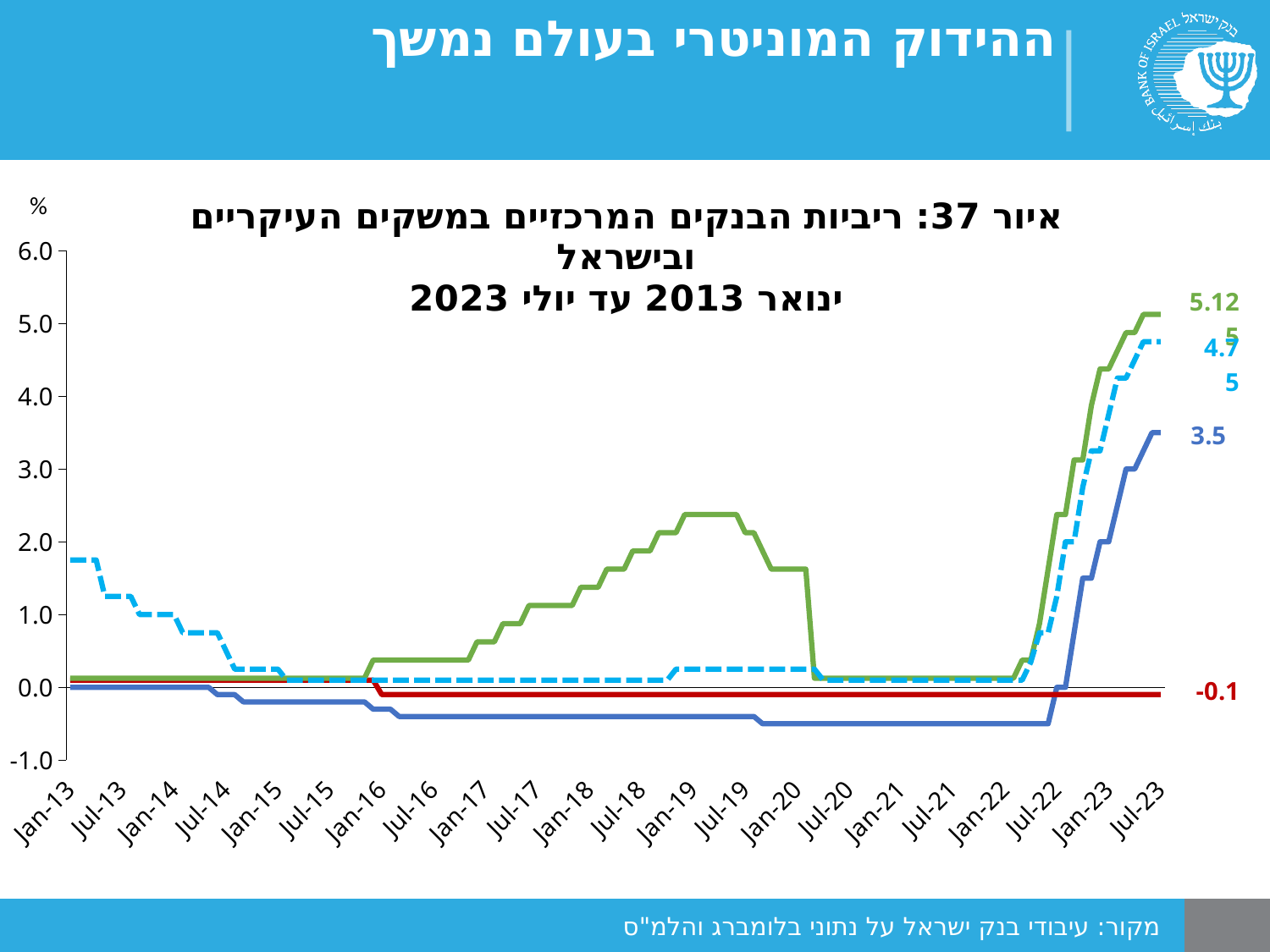
What kind of chart is shown on the slide? line chart Around Jan-19, is the value of the green line greater or less than 2.0? greater How many lines are plotted on the chart? 4 Around Jan-21, is the value of the dark blue line greater or less than 0.0? less What is the difference between the end values of the green line (5.12) and the dark blue line (3.5)? 1.62 Which line ends at the highest value at the right edge of the chart? the green line At the right edge of the chart, which is larger: the end value of the dark blue line or the end value of the red line? the dark blue line What is the final value labelled at the end of the green line? 5.12 What is the final value labelled at the end of the red line? -0.1 What is the final value labelled at the end of the dark blue line? 3.5 Does the green line rise or fall between Jan-22 and Jul-23? rise Which line ends at the lowest value at the right edge of the chart? the red line